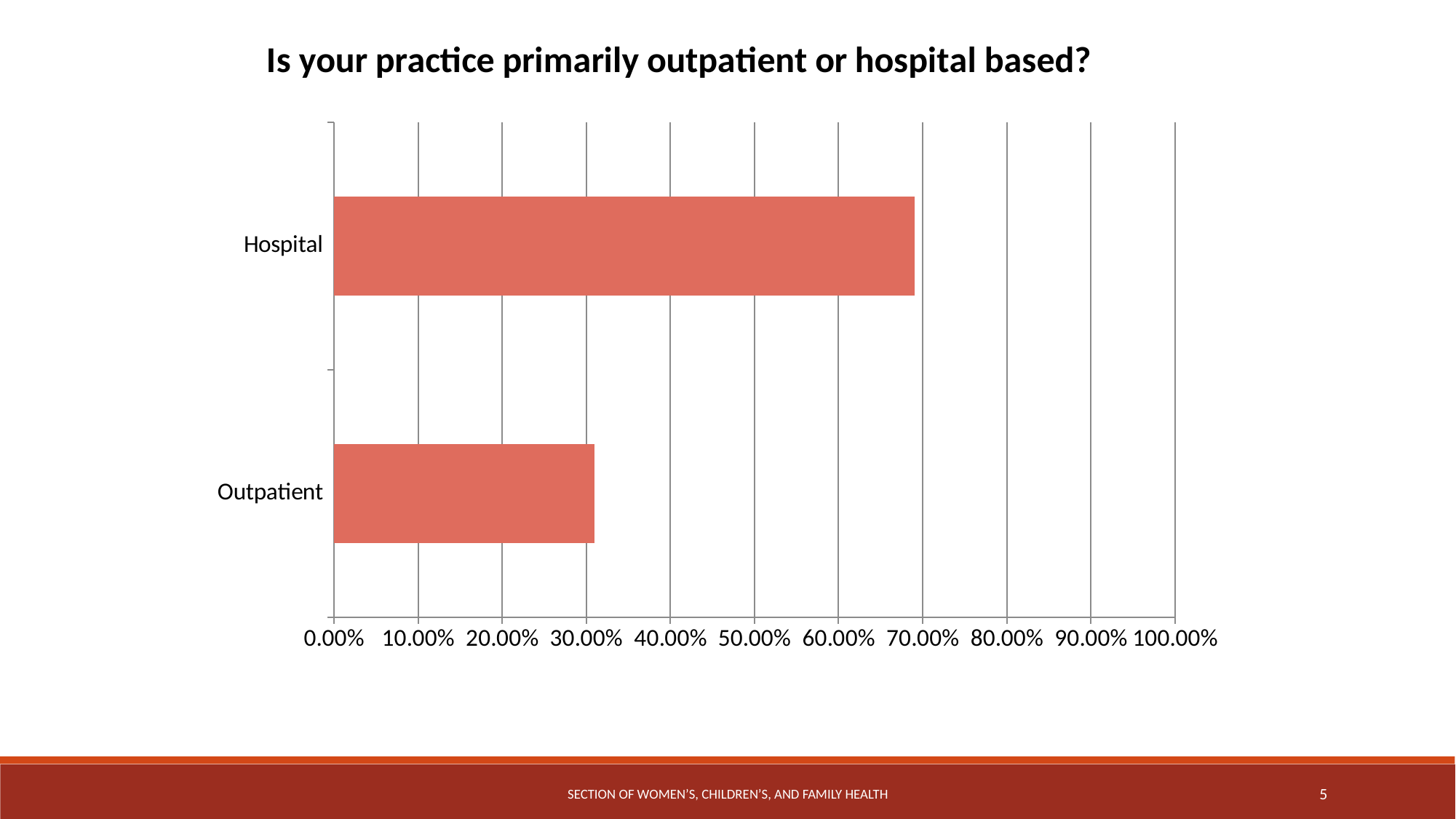
Is the value for Hospital greater or less than 80.00%? less Which category has the lowest value? Outpatient How many categories are shown in the chart? 2 Is the value for Outpatient greater or less than 40.00%? less Is the value for Hospital greater or less than 60.00%? greater What is the title of the chart? Is your practice primarily outpatient or hospital based? Which category has the highest value? Hospital Which is larger, the value for Hospital or the value for Outpatient? Hospital What is the maximum value shown on the horizontal axis? 100.00% What type of chart is shown on the slide? bar chart